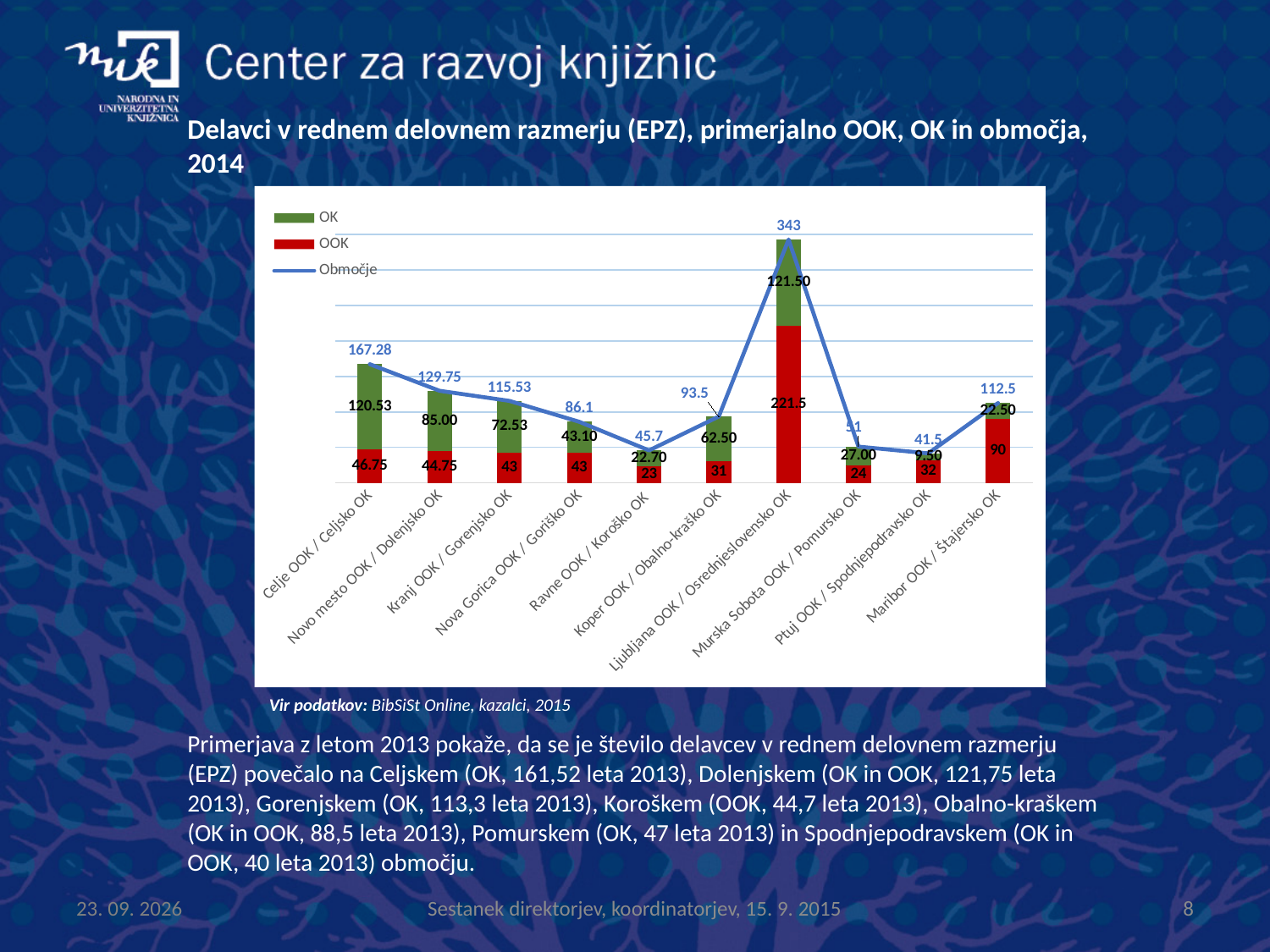
Which category has the highest Območje value? Ljubljana OOK / Osrednjeslovensko OK Which category has the lowest Območje value? Ptuj OOK / Spodnjepodravsko OK What is the total of the stacked bar for Ljubljana OOK / Osrednjeslovensko OK (OOK plus OK)? 343 How many categories are shown on the x axis of the chart? 10 What is the OK value for Celje OOK / Celjsko OK? 120.53 What is the OK value for Ptuj OOK / Spodnjepodravsko OK? 9.50 How many series does the chart legend list? 3 What is the Območje value for Maribor OOK / Štajersko OK? 112.5 Which has a larger OK value, Kranj OOK / Gorenjsko OK or Koper OOK / Obalno-kraško OK? Kranj OOK / Gorenjsko OK What is the difference between the Območje values for Celje OOK / Celjsko OK and Novo mesto OOK / Dolenjsko OK? 37.53 What kind of chart is shown on the slide? Stacked bar chart with a line What is the OOK value for Ljubljana OOK / Osrednjeslovensko OK? 221.5